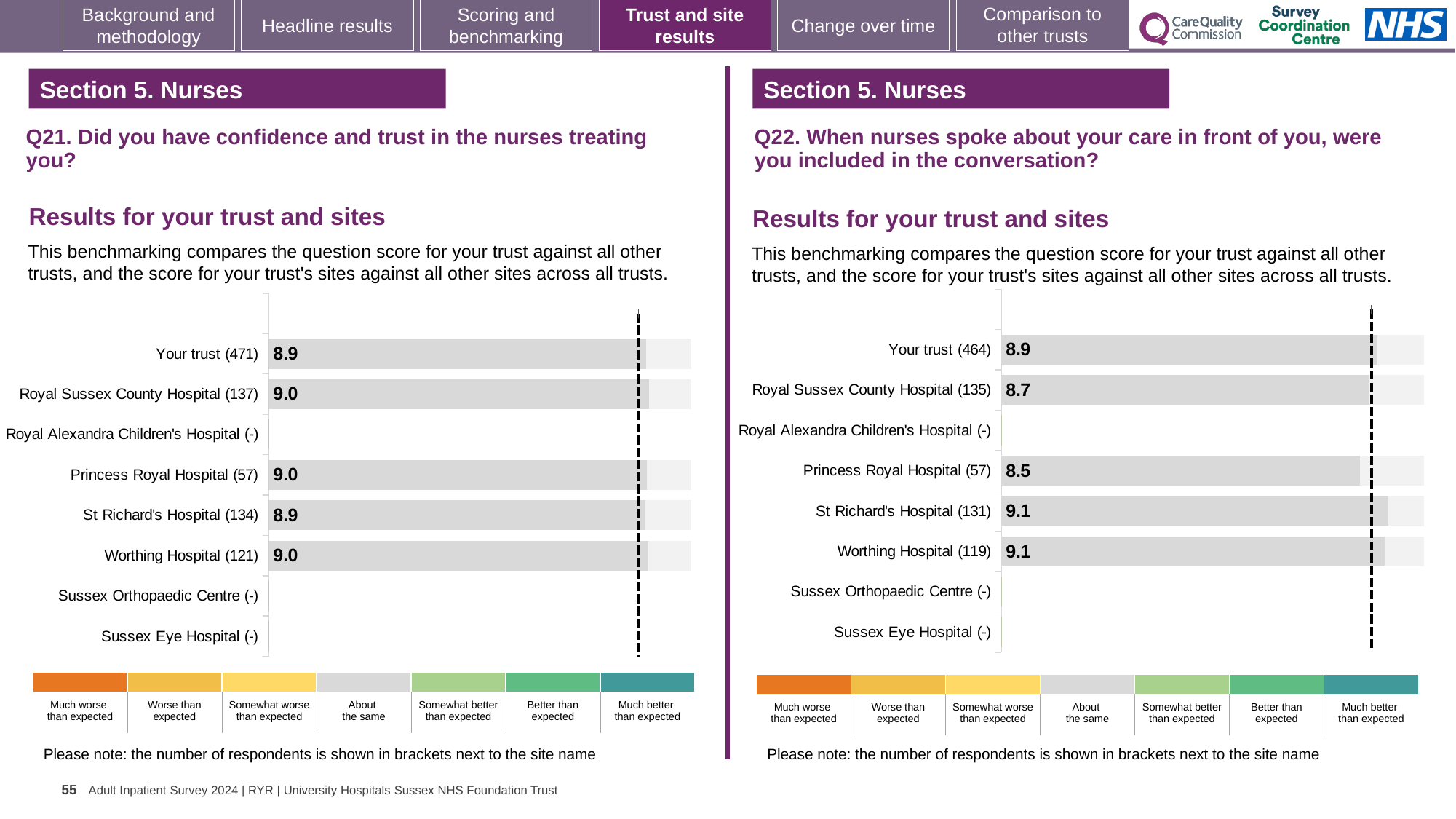
In the Q22 chart on the right, what is the score for Princess Royal Hospital? 8.5 In the Q22 chart on the right, what is the difference between the scores for St Richard's Hospital and Princess Royal Hospital? 0.6 In the Q22 chart on the right, which has the higher score, Royal Sussex County Hospital or Princess Royal Hospital? Royal Sussex County Hospital In the Q21 chart on the left, how many sites (including Your trust) have a score bar plotted? 5 In the Q22 chart on the right, which site has the lowest score? Princess Royal Hospital How many benchmark categories does the colour legend below the Q21 chart on the left list? 7 In the Q21 chart on the left, which has the higher score, Royal Sussex County Hospital or St Richard's Hospital? Royal Sussex County Hospital In the Q21 chart on the left, how many respondents are shown in brackets for Your trust? 471 In the Q21 chart on the left, what is the score for Worthing Hospital? 9.0 In the Q21 chart on the left, what is the score for Your trust? 8.9 What kind of chart is used in the Q22 chart on the right? Bar chart In the Q22 chart on the right, what is the score for Royal Sussex County Hospital? 8.7